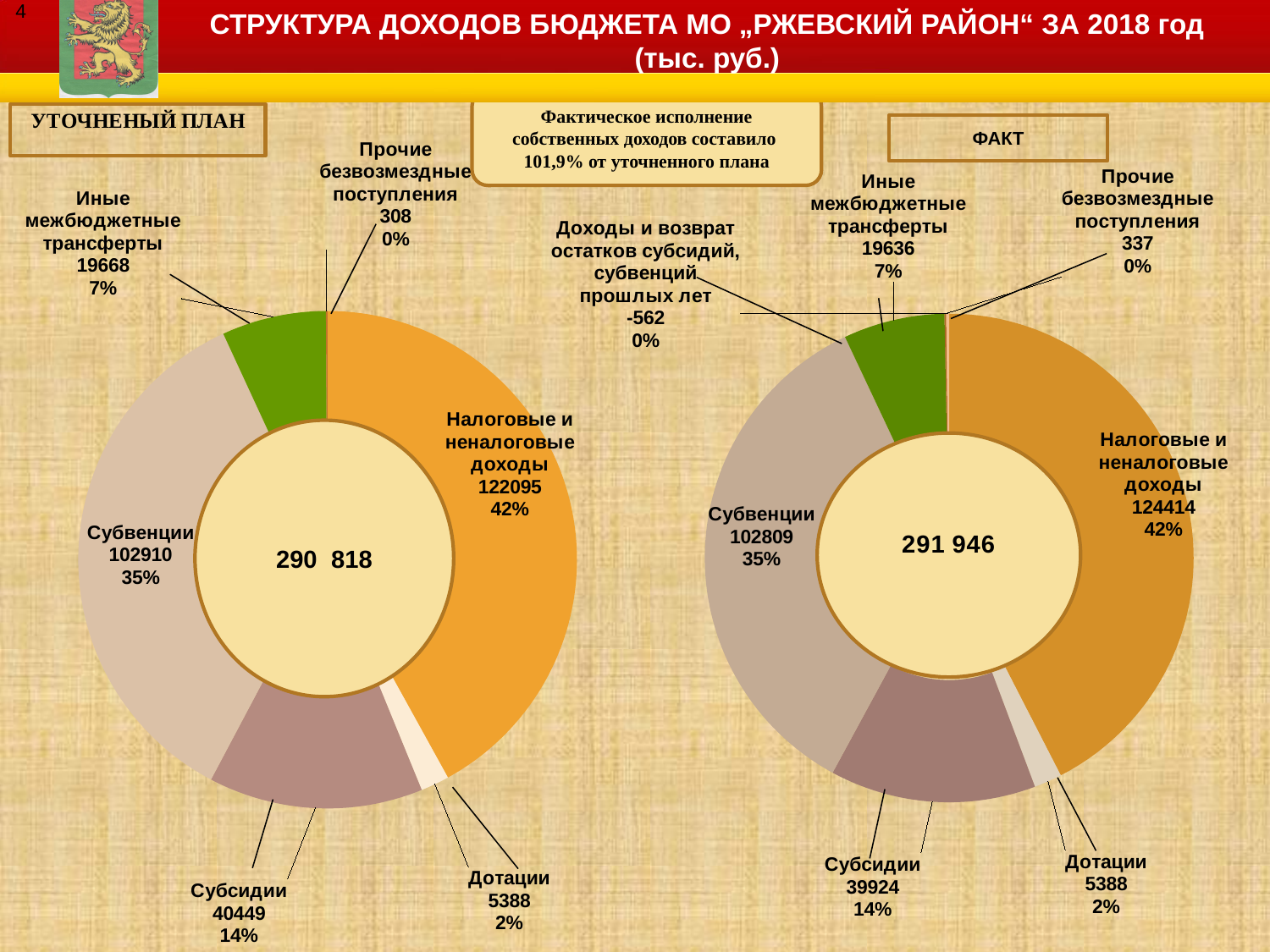
On the left chart (УТОЧНЕНЫЙ ПЛАН), which category has the smallest value? Прочие безвозмездные поступления On the left chart (УТОЧНЕНЫЙ ПЛАН), which category has the largest value? Налоговые и неналоговые доходы How many categories are shown on the right chart (ФАКТ)? 7 On the right chart (ФАКТ), what is the difference between Налоговые и неналоговые доходы and Субвенции? 21605 Which is larger: Субсидии on the left chart (УТОЧНЕНЫЙ ПЛАН) or Субсидии on the right chart (ФАКТ)? Left chart (УТОЧНЕНЫЙ ПЛАН), 40449 On the right chart (ФАКТ), what is the value for Доходы и возврат остатков субсидий, субвенций прошлых лет? -562 On the right chart (ФАКТ), what share of the total do Субсидии represent? 14% On the right chart (ФАКТ), what is the value for Субвенции? 102809 On the left chart (УТОЧНЕНЫЙ ПЛАН), what is the value for Налоговые и неналоговые доходы? 122095 How many categories are shown on the left chart (УТОЧНЕНЫЙ ПЛАН)? 6 What total is shown in the centre of the left chart (УТОЧНЕНЫЙ ПЛАН)? 290 818 What type of chart is used on the slide? Doughnut (pie) chart